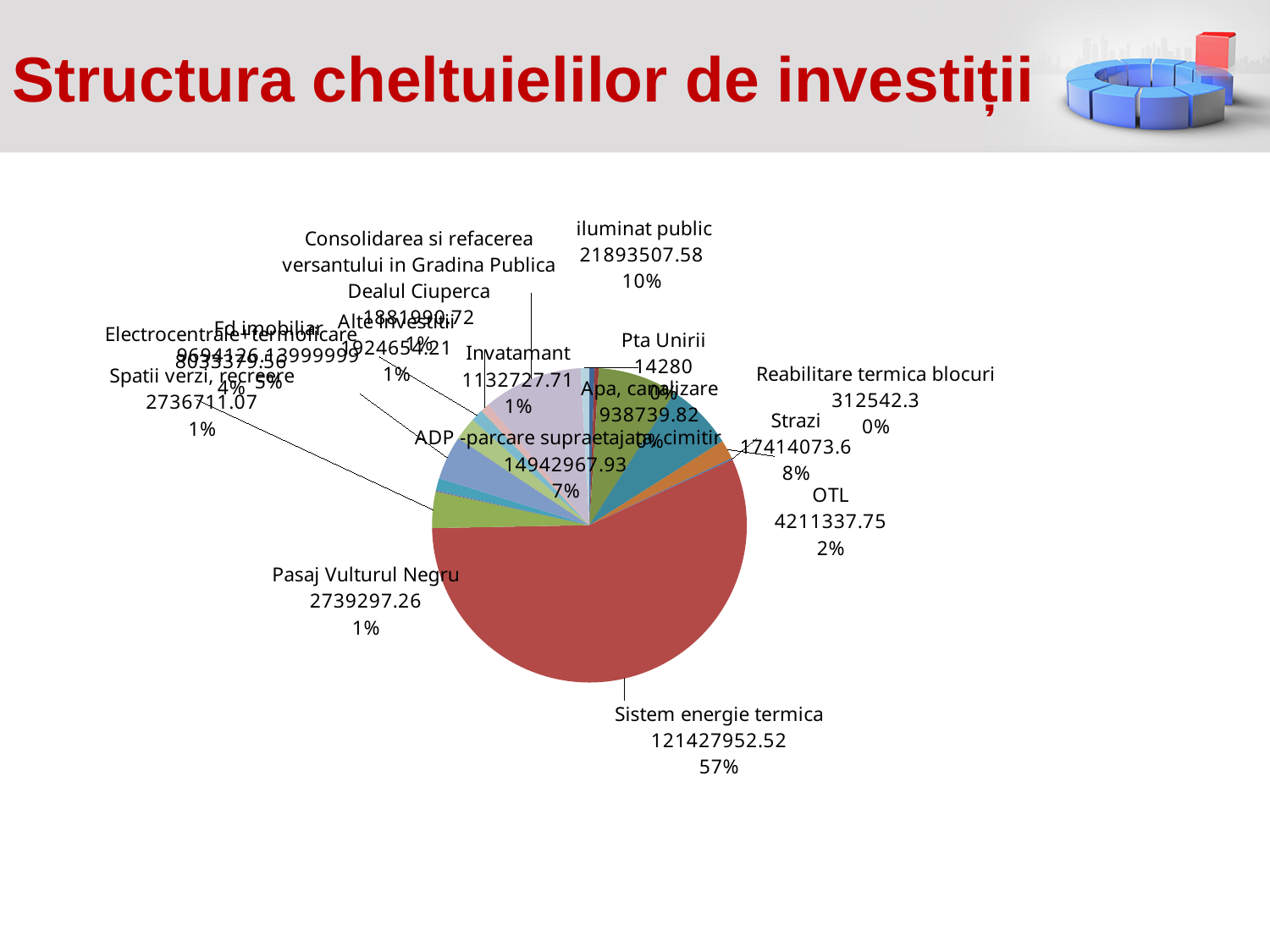
What percentage is shown for Strazi? 8% What is the difference between the value for iluminat public and the value for Strazi? 4479433.98 Which is larger, the value for iluminat public or the value for Strazi? iluminat public What is the title of the slide containing the chart? Structura cheltuielilor de investiții What percentage is shown for ADP -parcare supraetajata, cimitir? 7% What kind of chart is shown on the slide? pie chart What is the value shown for Sistem energie termica? 121427952.52 What is the value shown for Pasaj Vulturul Negru? 2739297.26 What is the value shown for iluminat public? 21893507.58 Which category has the largest slice of the pie? Sistem energie termica What is the value shown for OTL? 4211337.75 What share of the pie does Sistem energie termica represent? 57%